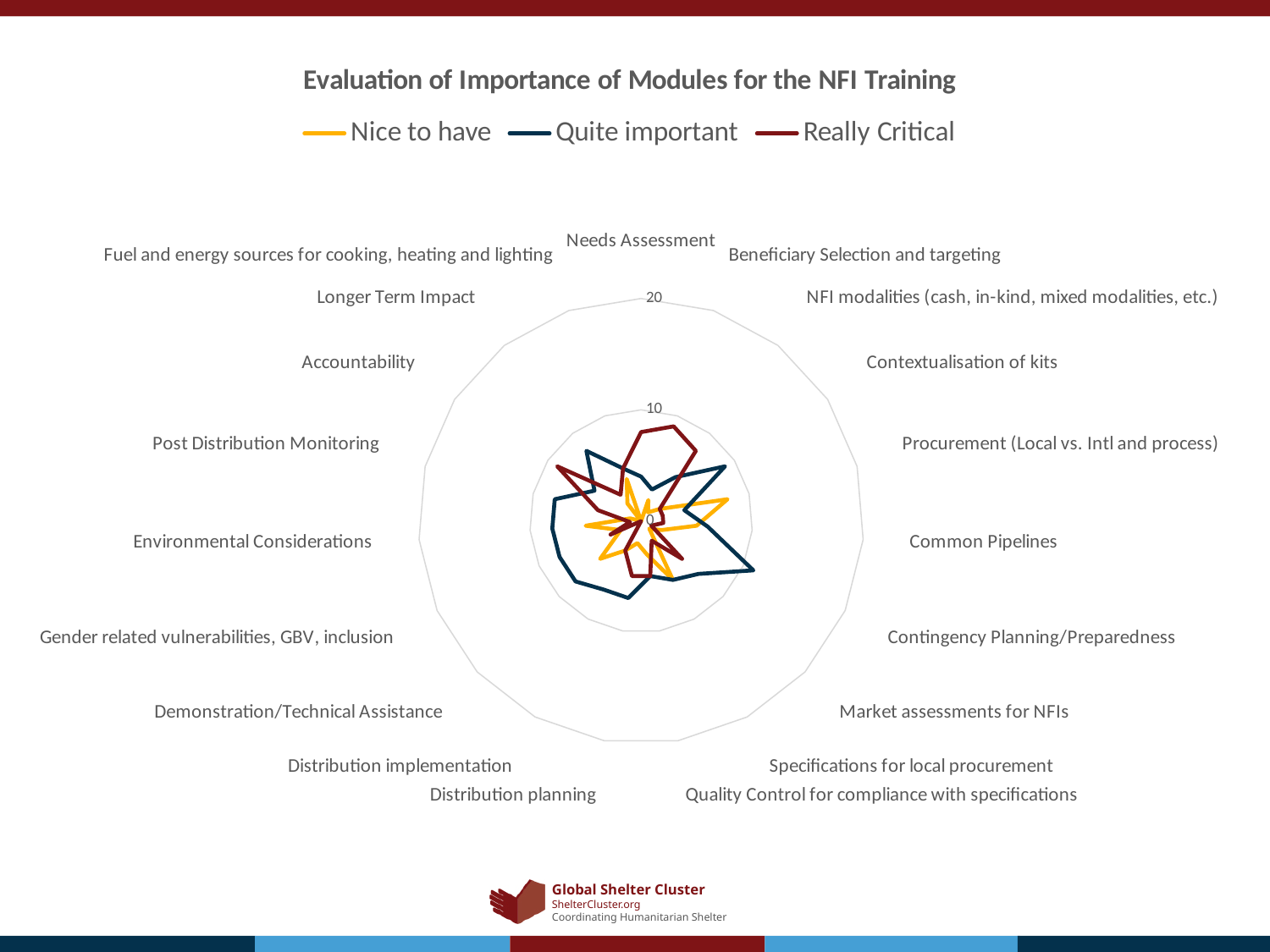
What is the title of the chart? Evaluation of Importance of Modules for the NFI Training Is the value for Common Pipelines in the Quite important series greater or less than 20? less Is the value for Accountability in the Nice to have series greater or less than 10? less Is the value for Needs Assessment in the Really Critical series greater or less than 20? less What kind of chart is shown on the slide? Radar chart What is the highest value shown on the chart's axis scale? 20 How many series does the legend list? 3 How many categories (modules) are plotted around the chart? 19 Which series is drawn in yellow/orange in the legend? Nice to have